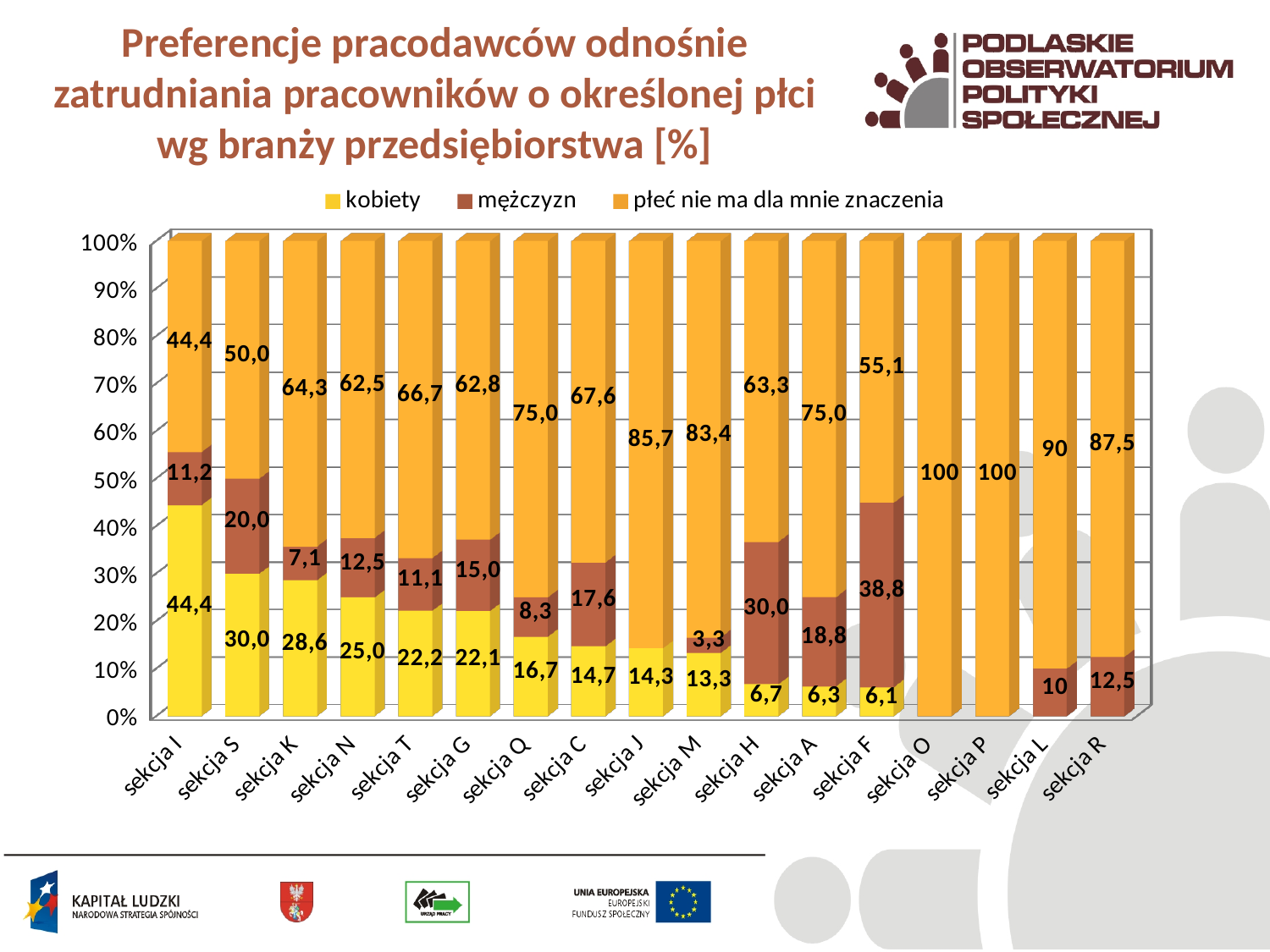
Which category has the highest value for 'mężczyzn'? sekcja F What is the value for 'mężczyzn' in sekcja F? 38,8 What is the value for 'mężczyzn' in sekcja L? 10 How many series does the legend list? 3 What is the value for 'płeć nie ma dla mnie znaczenia' in sekcja J? 85,7 Which is larger: the 'kobiety' value for sekcja S or for sekcja K? sekcja S Which series is shown in yellow in the legend? kobiety What is the value for 'kobiety' in sekcja I? 44,4 How many categories (sekcje) are shown on the x axis? 17 What is the difference between the 'mężczyzn' values for sekcja H and sekcja A? 11,2 What kind of chart is shown on the slide? stacked bar chart Which category has the highest value for 'kobiety'? sekcja I